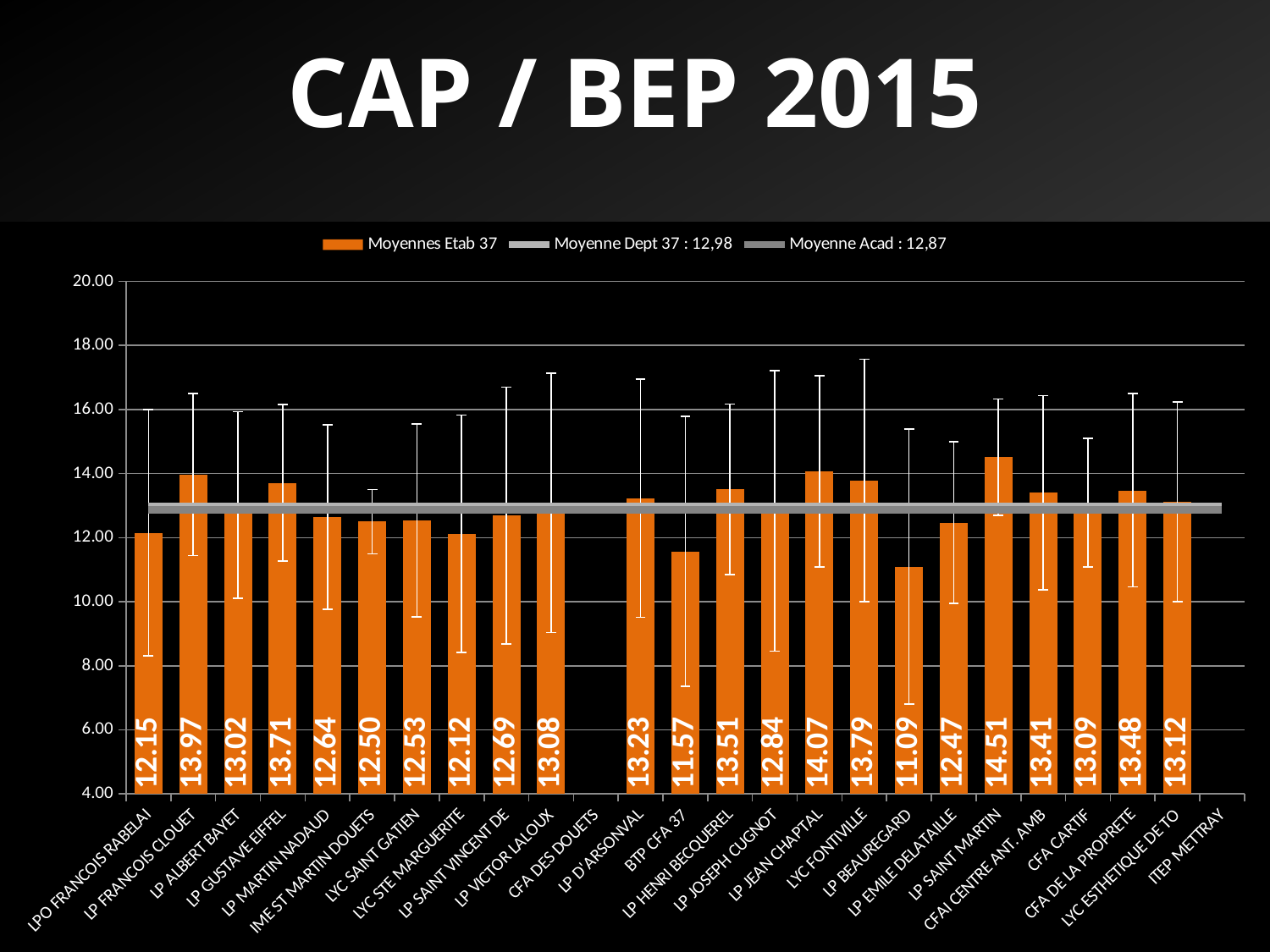
What is the title of the slide? CAP / BEP 2015 Which is larger, the value for LP FRANCOIS CLOUET or the value for LPO FRANCOIS RABELAI? LP FRANCOIS CLOUET How many series does the legend list? 3 What is the Moyenne Dept 37 value given in the legend? 12,98 What is the value for LP GUSTAVE EIFFEL? 13.71 What is the value for BTP CFA 37? 11.57 What kind of chart is shown? bar chart Is the value for LP BEAUREGARD greater or less than 12.00? less What is the value for LP SAINT MARTIN? 14.51 Which establishment has the highest value? LP SAINT MARTIN What is the difference between the values for LP JEAN CHAPTAL and BTP CFA 37? 2.50 Which establishment has the lowest value? LP BEAUREGARD